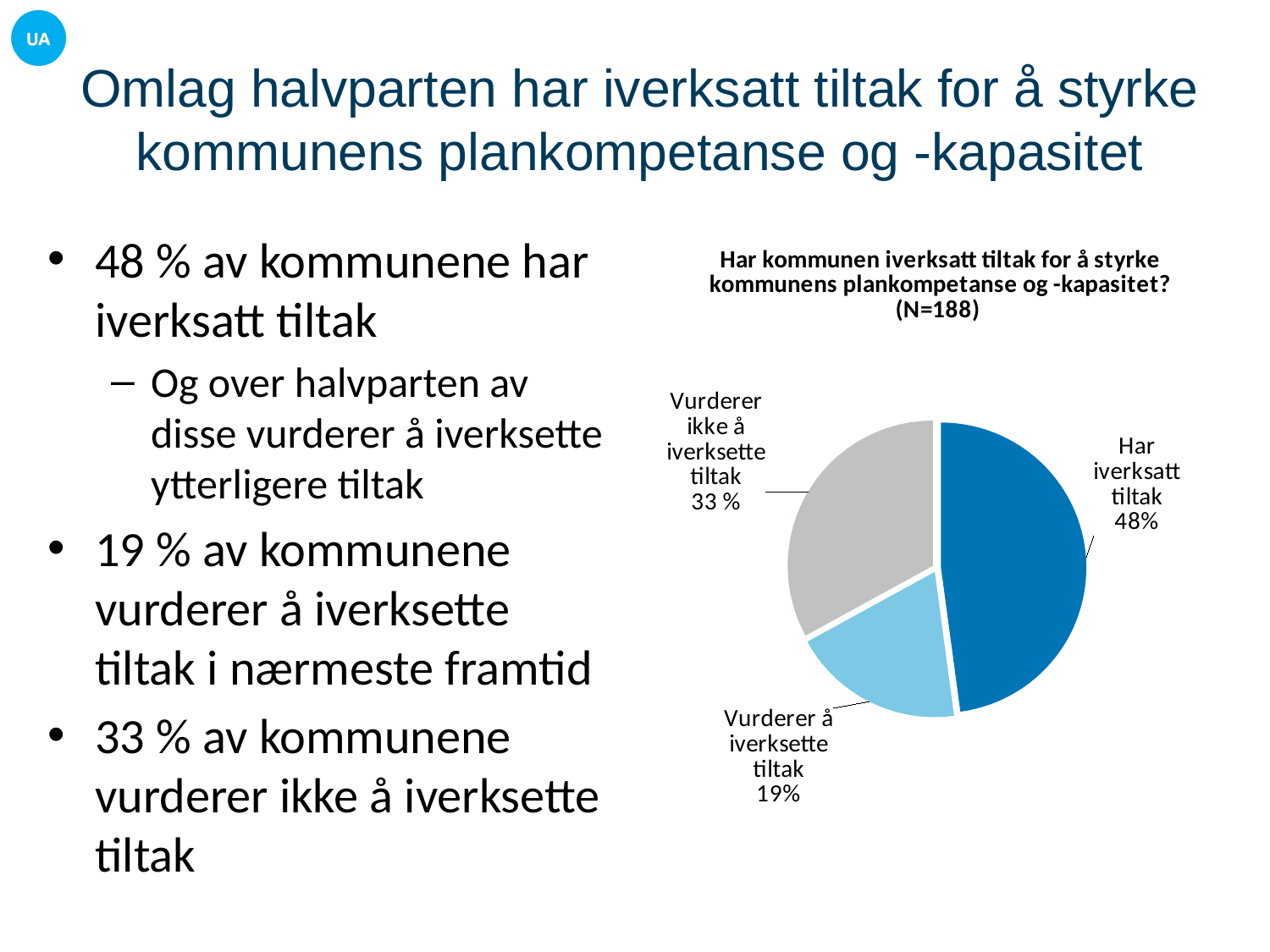
What share of the pie is labelled "Vurderer ikke å iverksette tiltak"? 33 % What share of the pie is labelled "Har iverksatt tiltak"? 48% What is the difference in percentage points between the "Har iverksatt tiltak" slice and the "Vurderer ikke å iverksette tiltak" slice? 15 What colour is the "Har iverksatt tiltak" slice? dark blue What share of the pie is labelled "Vurderer å iverksette tiltak"? 19% What is the difference in percentage points between the "Vurderer ikke å iverksette tiltak" slice and the "Vurderer å iverksette tiltak" slice? 14 Which slice of the pie chart is the smallest? Vurderer å iverksette tiltak What kind of chart is shown on the slide? pie chart Which slice of the pie chart is the largest? Har iverksatt tiltak Which is larger: the "Vurderer ikke å iverksette tiltak" slice or the "Vurderer å iverksette tiltak" slice? Vurderer ikke å iverksette tiltak What is the sample size (N) stated in the chart title? N=188 How many slices does the pie chart have? 3